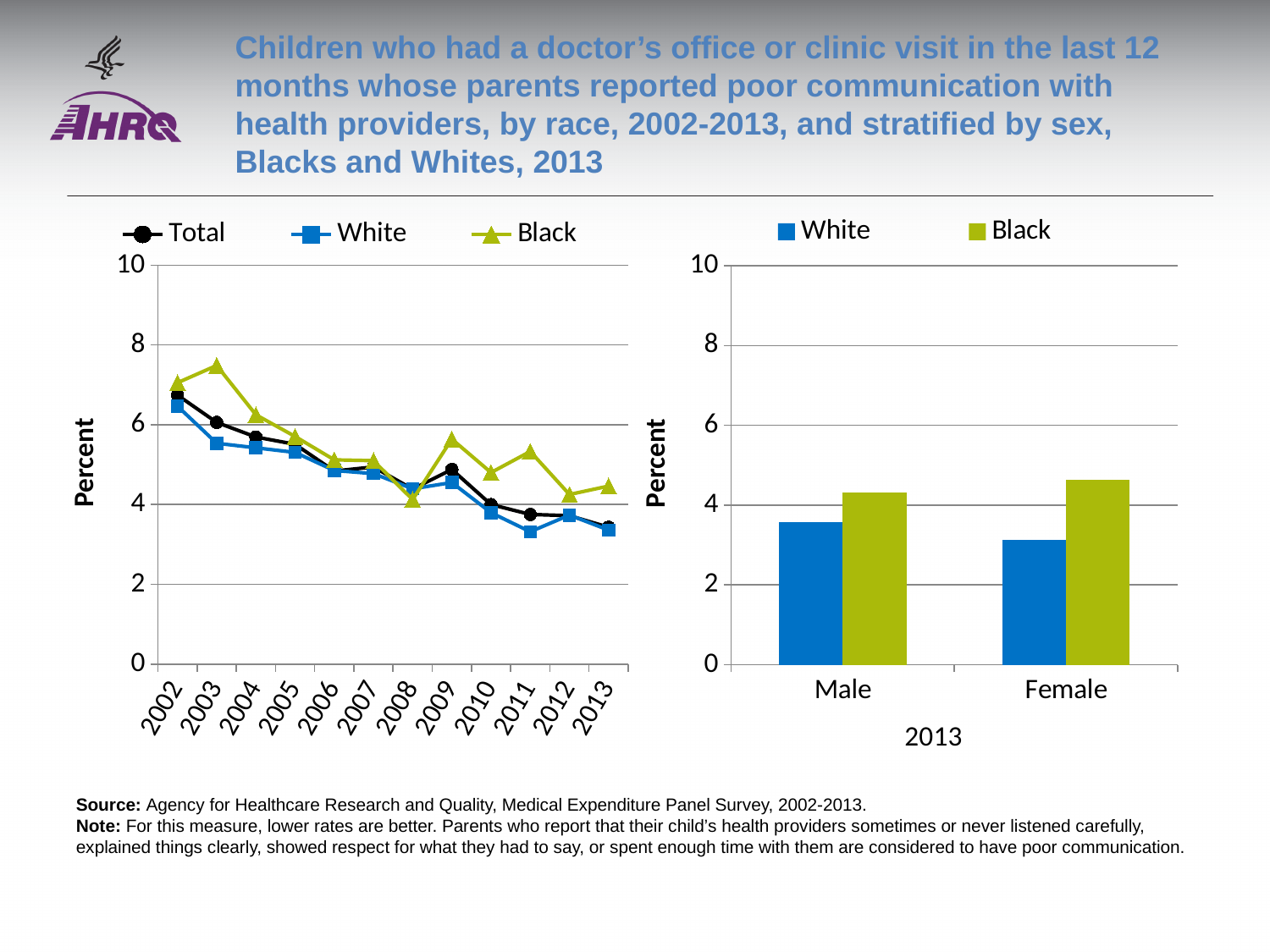
How many years are shown on the x axis of the left chart? 12 What kind of chart is the left chart showing rates by race from 2002 to 2013? line chart In the right chart, which is larger for Females, White or Black? Black In the left chart, do the values for the Total series generally rise or fall from 2002 to 2013? fall In the left chart, which series has the highest value in 2003? Black How many series does the legend of the right chart list? 2 In the right chart, is the value for Black among Females greater or less than 4? greater In the left chart, is the value for Black in 2003 greater or less than 6? greater How many series does the legend of the left chart list? 3 What kind of chart is the right chart showing rates by sex for 2013? bar chart In the right chart, which bar is the lowest? White, Female In the left chart, is the value for White in 2013 greater or less than 4? less